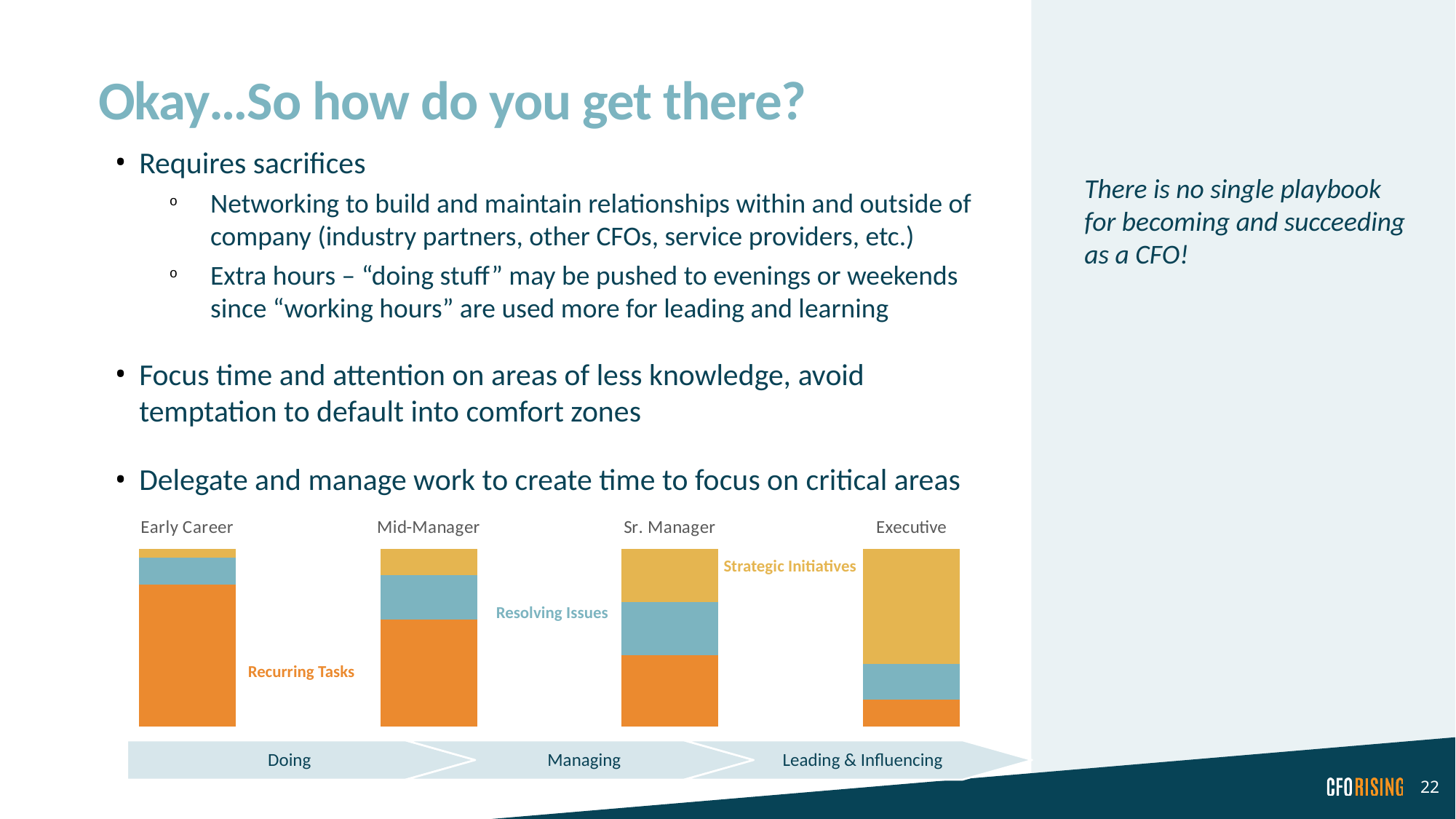
Which career stage has the smallest Strategic Initiatives segment? Early Career What colour represents Recurring Tasks in the bar chart? Orange What kind of chart is shown at the bottom of the slide? Stacked bar chart How many series (segment types) does the bar chart show? 3 Which career stage has the largest Strategic Initiatives segment? Executive Does the Strategic Initiatives segment rise or fall from Early Career to Executive? Rise Does the Recurring Tasks segment rise or fall from Early Career to Executive? Fall In the Executive bar, which segment is larger: Strategic Initiatives or Resolving Issues? Strategic Initiatives Is the Recurring Tasks segment larger for Mid-Manager or for Sr. Manager? Mid-Manager Which career stage has the smallest Recurring Tasks segment? Executive Which career stage has the largest Recurring Tasks segment? Early Career How many career stages (categories) are shown in the bar chart? 4